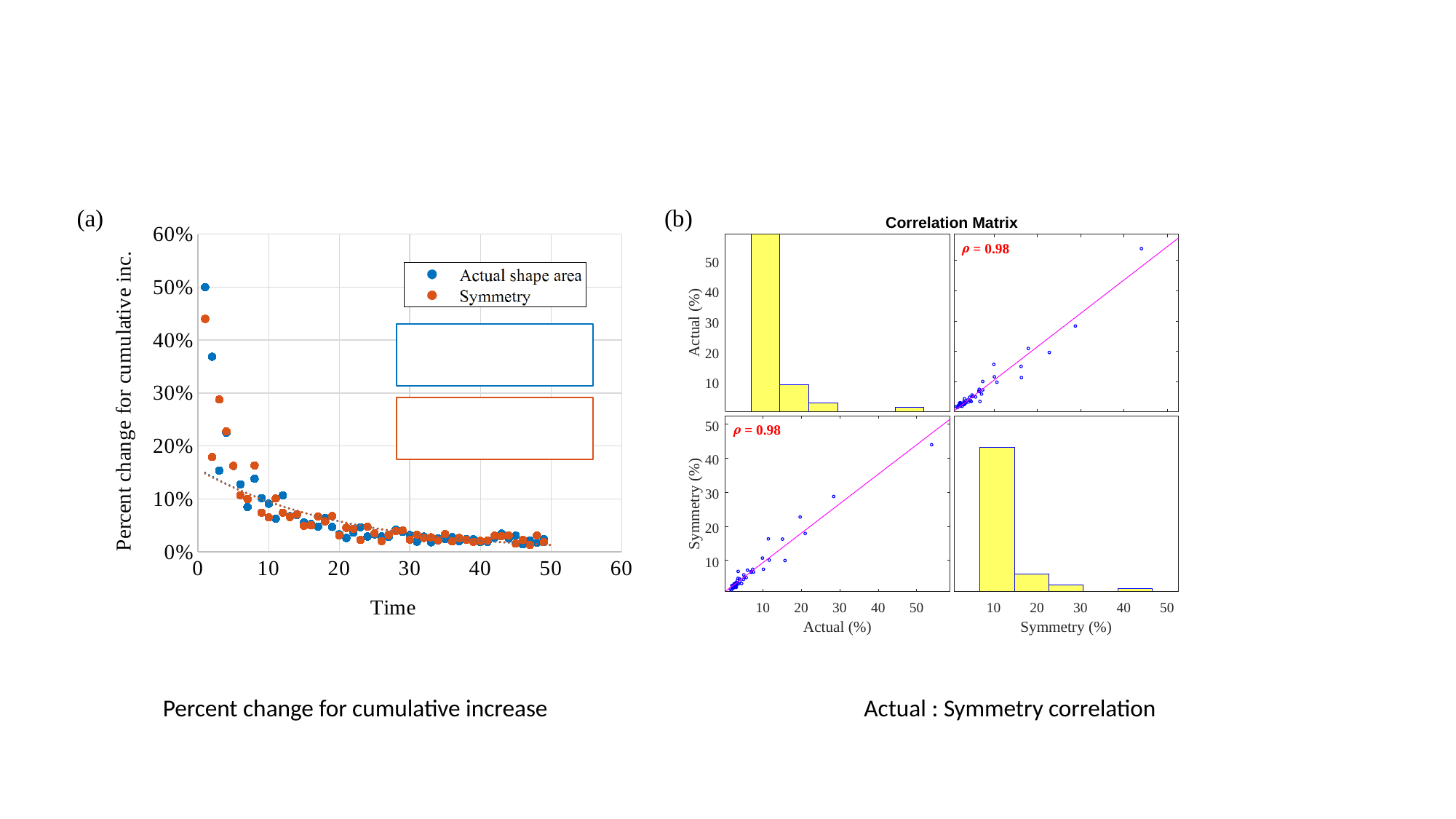
In chart (a), do the values generally rise or fall as Time increases? fall What kind of chart is chart (a), 'Percent change for cumulative increase'? scatter chart In chart (a), is the Actual shape area value at Time 3 greater or less than 30%? less In chart (a), is the Actual shape area value at Time 1 greater or less than 40%? greater In chart (a), is the Symmetry value at Time 1 greater or less than 40%? greater How many series does the legend of chart (a) list? 2 In chart (b), what correlation coefficient ρ is printed on the scatter panels? 0.98 What are the two series named in the legend of chart (a)? Actual shape area and Symmetry In chart (a), at Time 1, which series has the larger value, Actual shape area or Symmetry? Actual shape area What is the title of chart (b)? Correlation Matrix